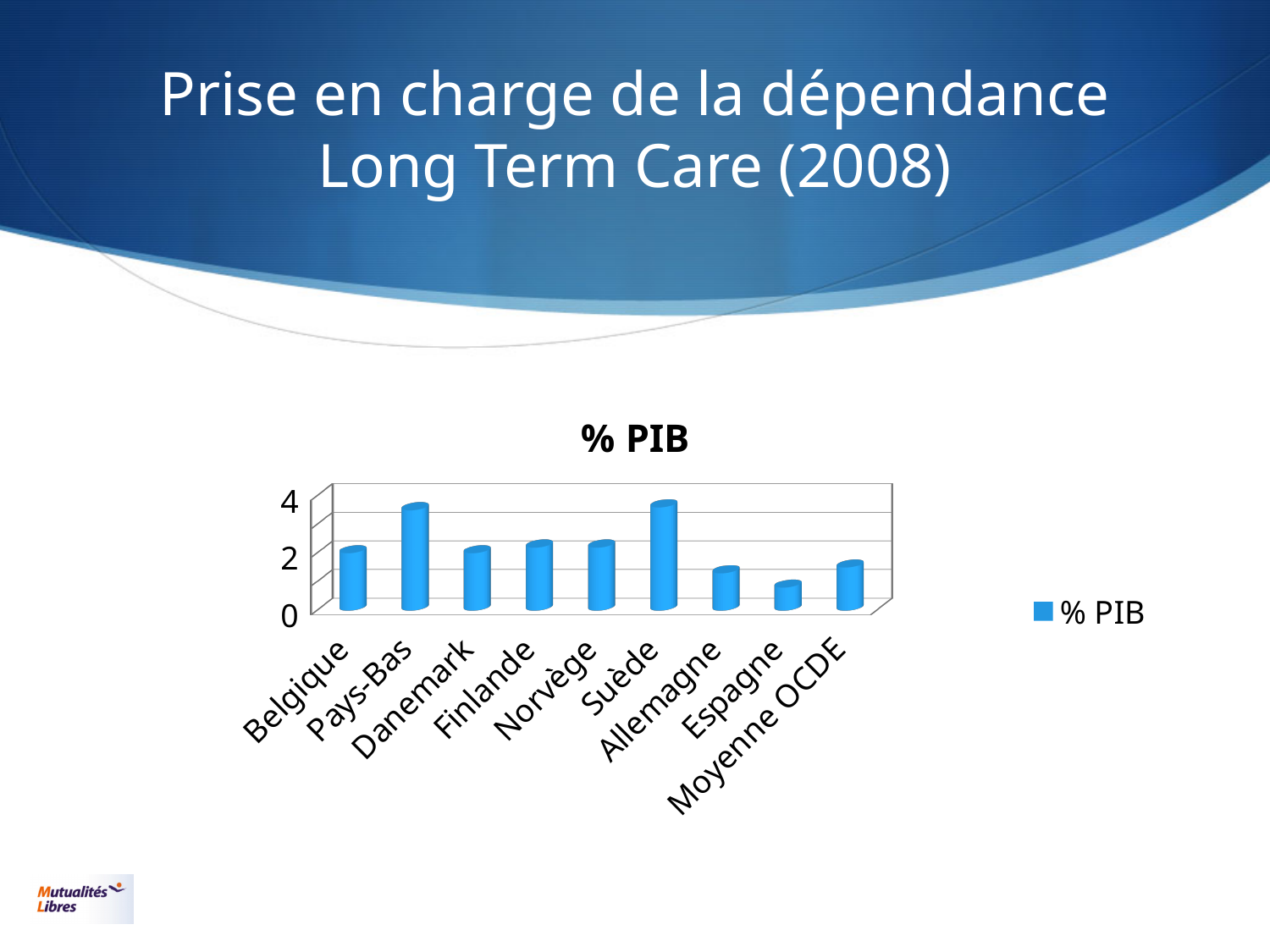
Is the value for Allemagne greater or less than 2? less What is the title of the chart? % PIB What is the name of the series listed in the legend? % PIB Which is larger, the value for Pays-Bas or the value for Espagne? Pays-Bas Which category has the lowest value in the chart? Espagne What kind of chart is shown on the slide? bar chart Which is larger, the value for Suède or the value for Allemagne? Suède Is the value for Pays-Bas greater or less than 2? greater How many categories are shown on the x axis of the chart? 9 How many series does the legend list? 1 Is the value for Espagne greater or less than 2? less